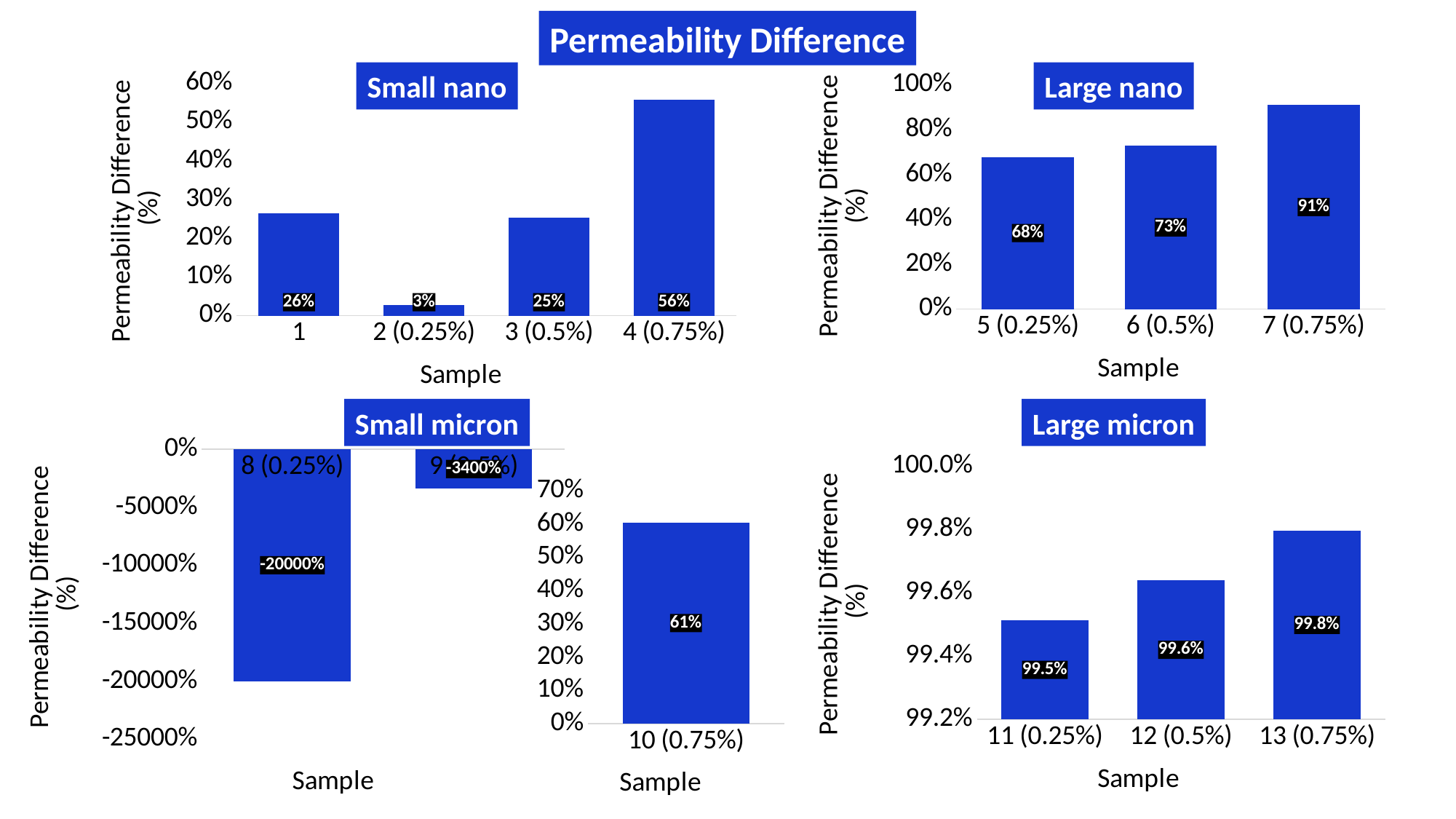
In the Large nano chart, what is the permeability difference for sample 6 (0.5%)? 73% In the Small nano chart, what is the difference between the values for sample 4 (0.75%) and sample 1? 30% In the Small nano chart, which sample has the lowest permeability difference? 2 (0.25%) In the Small nano chart, what is the permeability difference for sample 4 (0.75%)? 56% In the Small micron chart, what is the permeability difference for sample 10 (0.75%)? 61% How many samples are plotted in the Large nano chart? 3 In the Small nano chart, which sample has the highest permeability difference? 4 (0.75%) In the Small micron chart, what is the permeability difference for sample 8 (0.25%)? -20000% In the Large micron chart, what is the permeability difference for sample 13 (0.75%)? 99.8% What type of chart is the Large nano chart? Bar chart In the Large micron chart, which has the larger permeability difference, sample 11 (0.25%) or sample 12 (0.5%)? 12 (0.5%) In the Large nano chart, what is the difference between the values for sample 7 (0.75%) and sample 5 (0.25%)? 23%